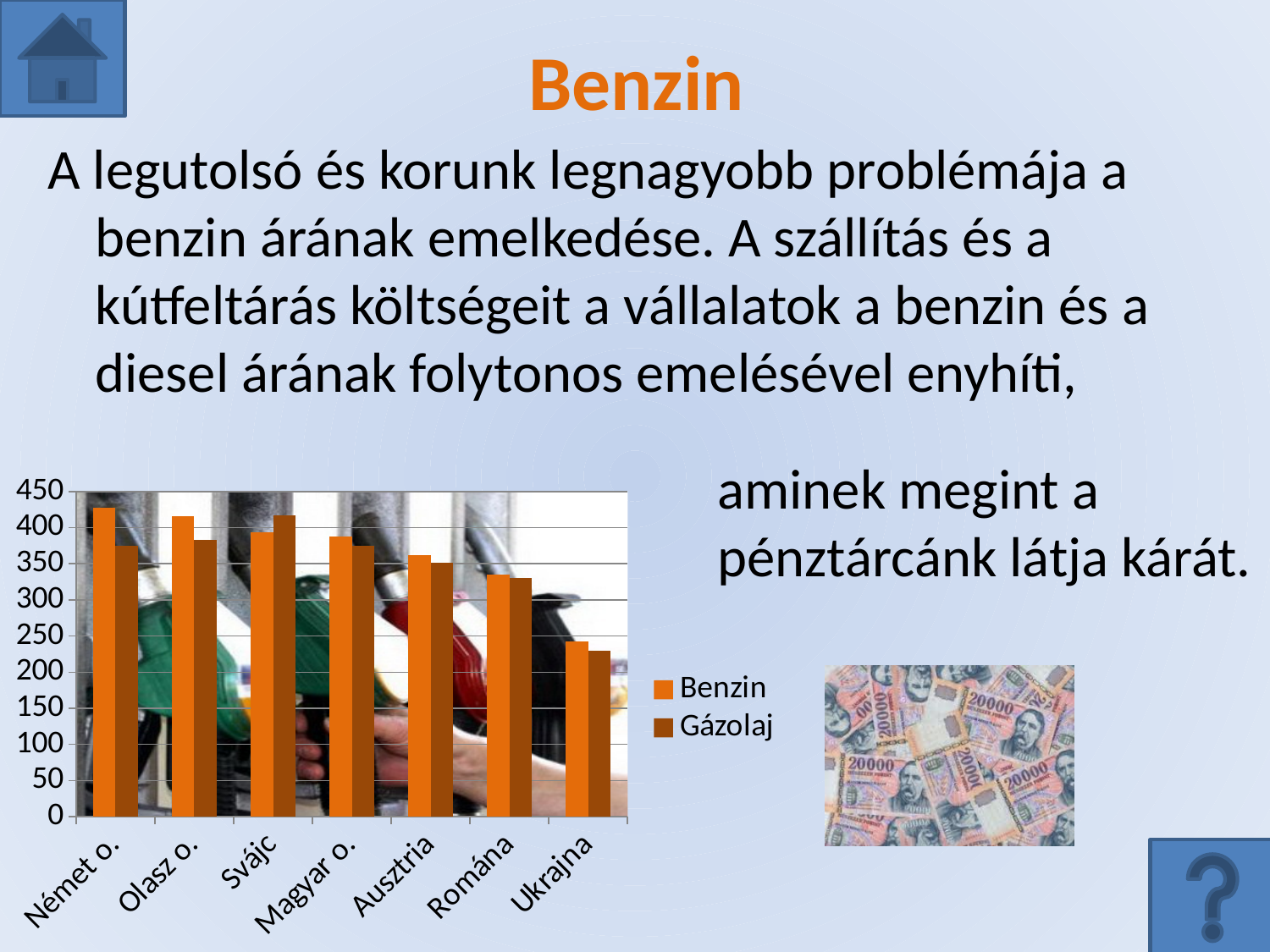
Which country has the lowest Benzin value? Ukrajna What kind of chart is shown on the slide? bar chart Which country has the lowest Gázolaj value? Ukrajna Is the Gázolaj value for Svájc greater or less than 400? greater Do the Benzin values generally rise or fall from Német o. to Ukrajna along the x axis? fall Is the Benzin value for Német o. greater or less than 400? greater How many countries are shown on the x axis of the chart? 7 For Svájc, which is larger: the Benzin value or the Gázolaj value? Gázolaj Which country has the highest Benzin value? Német o. How many series does the chart's legend list? 2 Which country has the highest Gázolaj value? Svájc